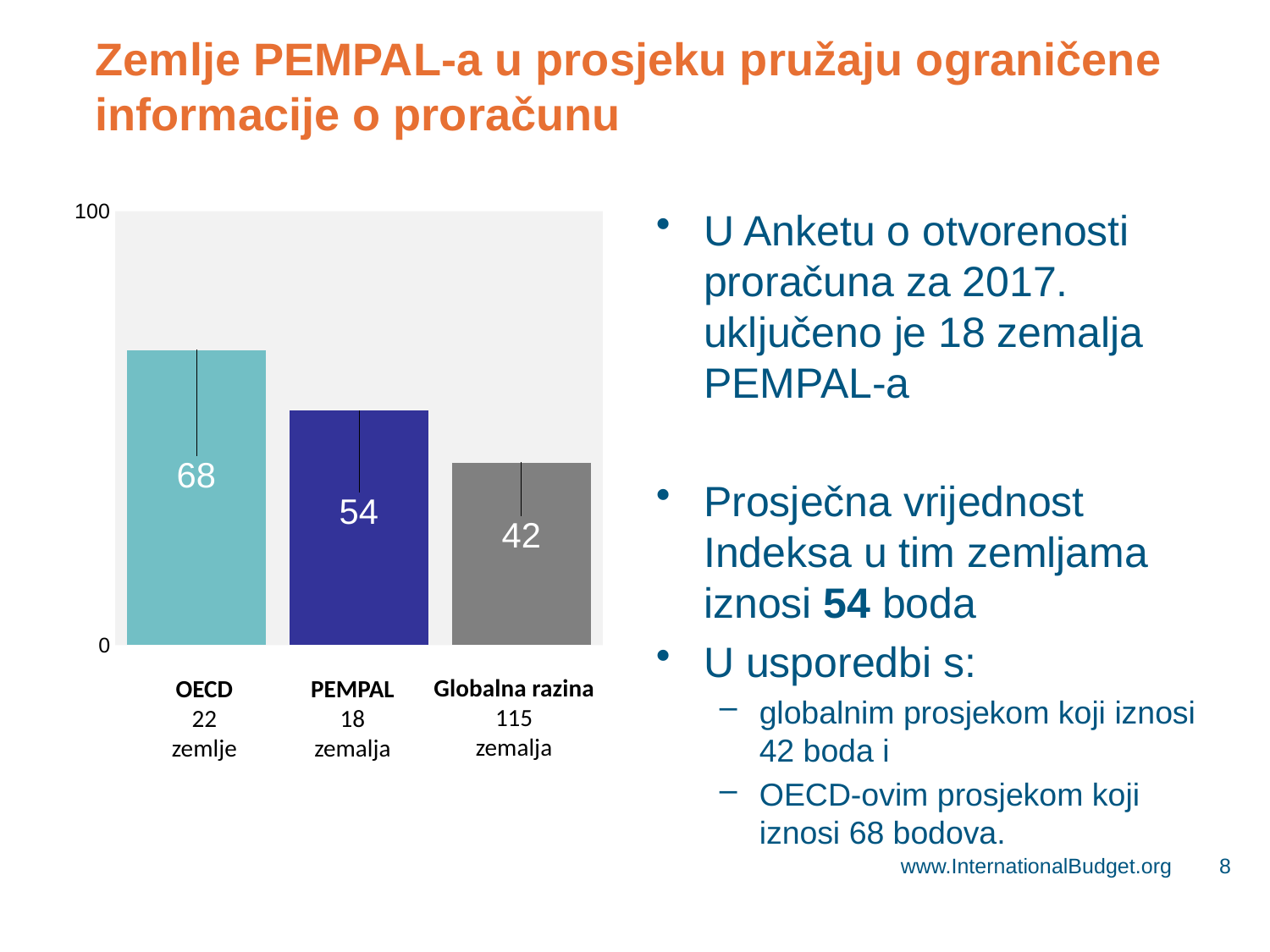
Do the values rise or fall from left to right across the bars? fall How many bars are shown in the chart? 3 Which category has the highest value? OECD Which is larger, the value for PEMPAL or the value for Globalna razina? PEMPAL What is the value for PEMPAL? 54 What is the value for Globalna razina? 42 Which category has the lowest value? Globalna razina What is the difference between the PEMPAL value and the Globalna razina value? 12 How many countries are listed under the Globalna razina bar? 115 What is the value for OECD? 68 What is the difference between the OECD value and the PEMPAL value? 14 What kind of chart is shown on the slide? bar chart